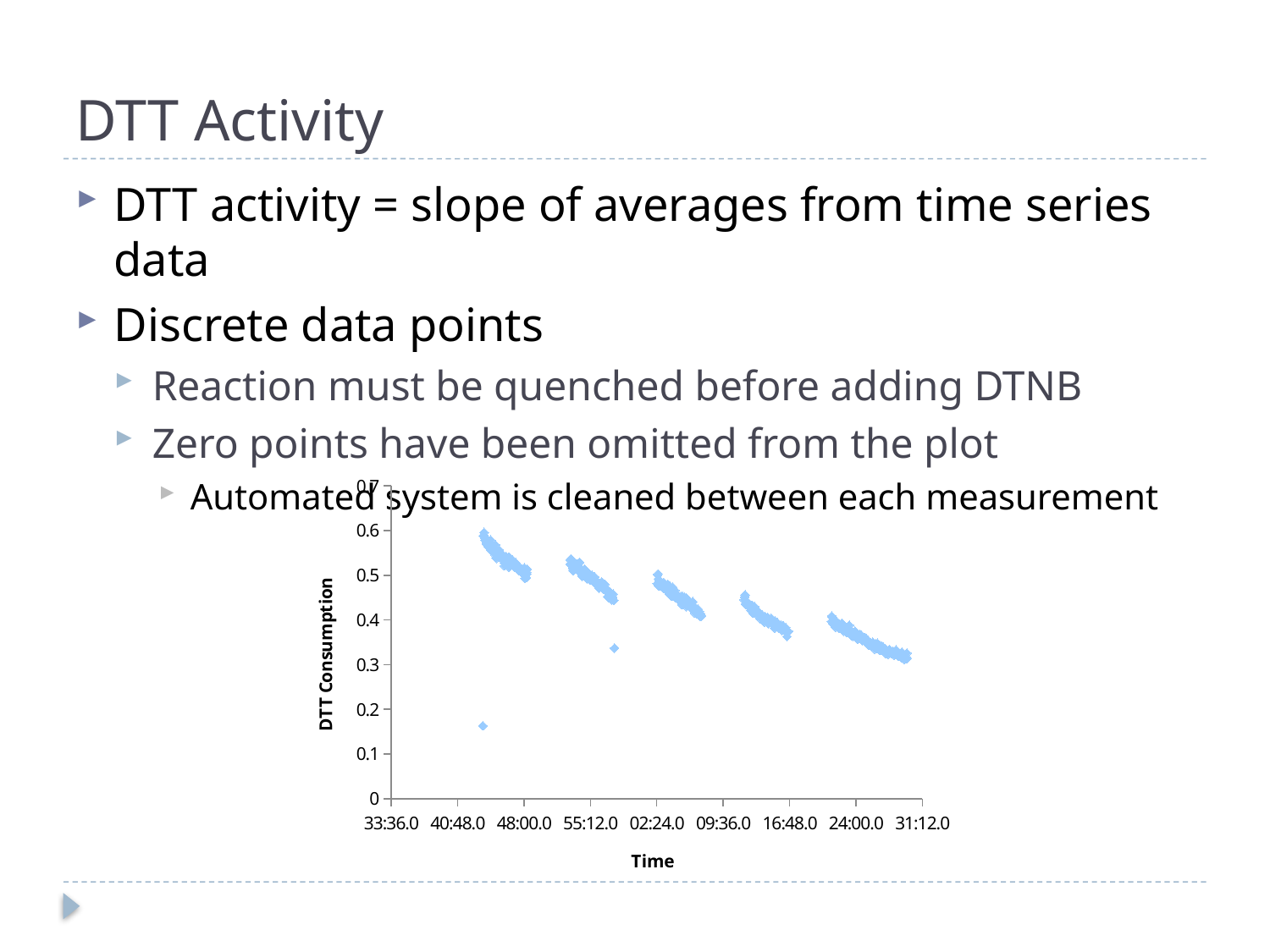
Do the DTT Consumption values generally rise or fall as time increases along the x axis? fall Is the highest plotted DTT Consumption value greater or less than 0.5? greater Is the lowest isolated data point in the chart greater or less than 0.2? less Are the values in the rightmost cluster of points greater or less than 0.5? less What is the title of the x axis of the chart? Time How many tick labels are shown on the x axis of the chart? 9 Which cluster has higher values: the leftmost cluster or the rightmost cluster? the leftmost cluster What is the title of the y axis of the chart? DTT Consumption How many distinct clusters of data points are plotted in the chart? 5 What kind of chart is shown on the slide? scatter chart What is the highest tick value shown on the y axis? 0.7